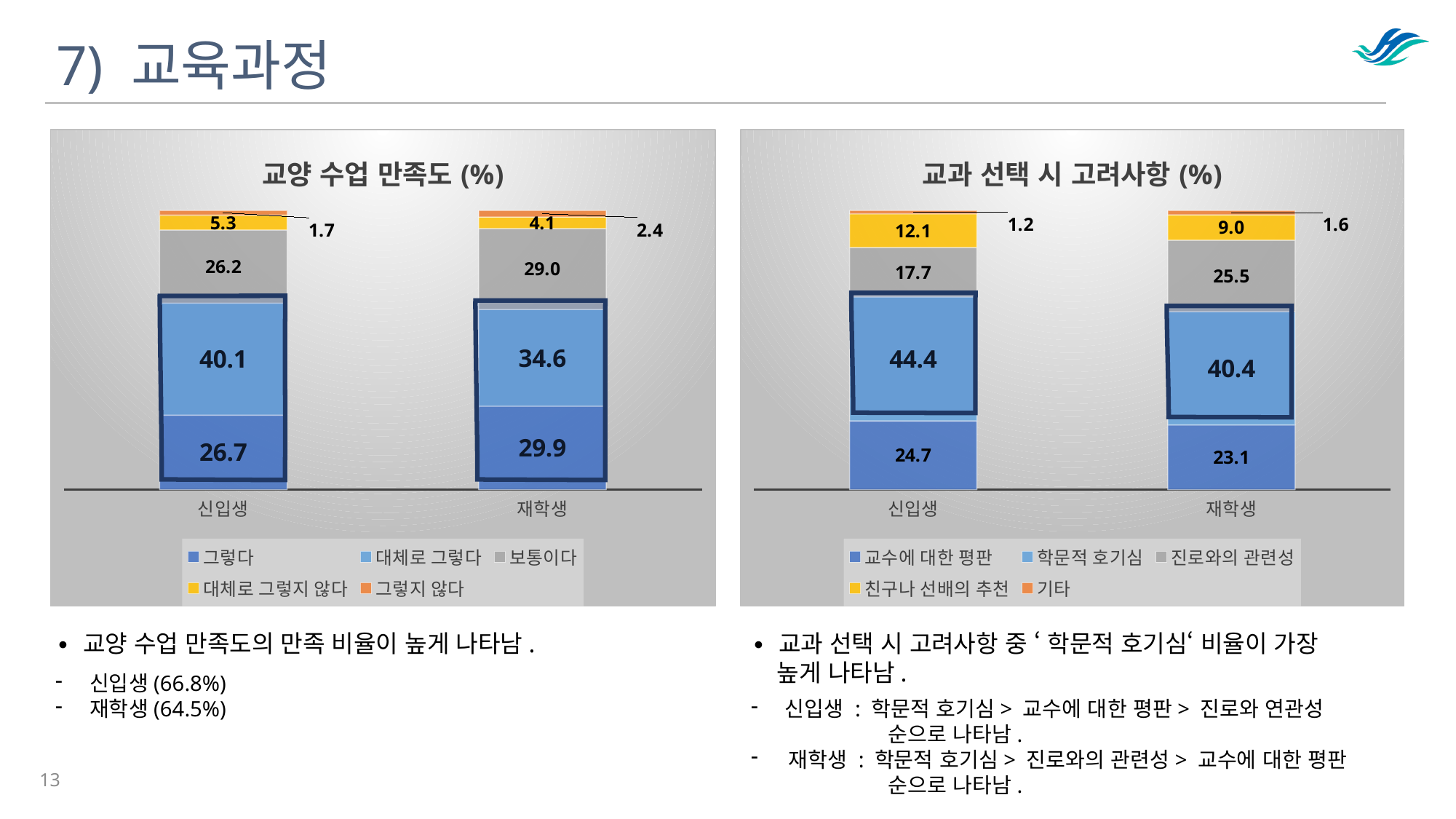
In the chart titled 교과 선택 시 고려사항 (%), what is the value of 학문적 호기심 for 신입생? 44.4 In the chart titled 교양 수업 만족도 (%), which group has the larger 보통이다 value, 신입생 or 재학생? 재학생 In the chart titled 교과 선택 시 고려사항 (%), what is the value of 진로와의 관련성 for 재학생? 25.5 In the chart titled 교과 선택 시 고려사항 (%), what is the value of 기타 for 재학생? 1.6 In the chart titled 교양 수업 만족도 (%), what is the difference between the 대체로 그렇다 values for 신입생 and 재학생? 5.5 In the chart titled 교과 선택 시 고려사항 (%), which series has the highest value for 재학생? 학문적 호기심 In the chart titled 교양 수업 만족도 (%), what is the value of 그렇지 않다 for 신입생? 1.7 What kind of chart is the chart titled 교과 선택 시 고려사항 (%)? Stacked bar chart In the chart titled 교과 선택 시 고려사항 (%), what is the difference between the 학문적 호기심 values for 신입생 and 재학생? 4.0 In the chart titled 교양 수업 만족도 (%), what is the value of 그렇다 for 재학생? 29.9 In the chart titled 교양 수업 만족도 (%), what is the value of 대체로 그렇다 for 신입생? 40.1 In the chart titled 교양 수업 만족도 (%), how many series does the legend list? 5